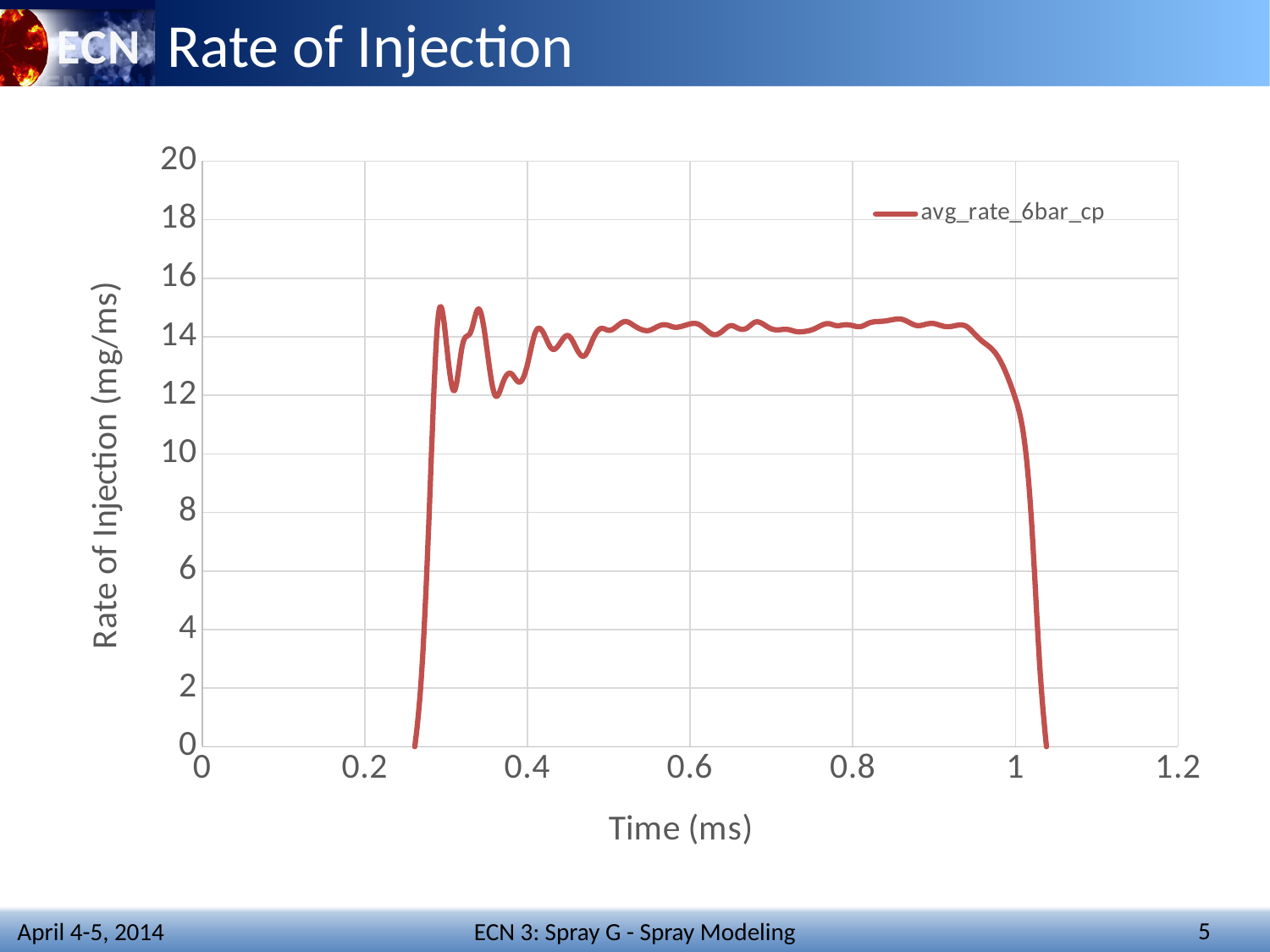
What kind of chart is shown on the slide? line chart How many series does the legend list? 1 Which is larger, the value of avg_rate_6bar_cp at 0.7 ms or at 1.02 ms? 0.7 ms Is the value for avg_rate_6bar_cp at 0.6 ms greater or less than 10? greater Does the value of avg_rate_6bar_cp rise or fall between 0.26 ms and 0.29 ms? rise Does the value of avg_rate_6bar_cp rise or fall between 1.0 ms and 1.04 ms? fall Is the value for avg_rate_6bar_cp at 0.5 ms greater or less than 18? less What is the highest tick value shown on the y axis? 20 What is the name of the series shown in the legend? avg_rate_6bar_cp Is the value for avg_rate_6bar_cp at 0.8 ms greater or less than 12? greater What is the label of the x axis? Time (ms)